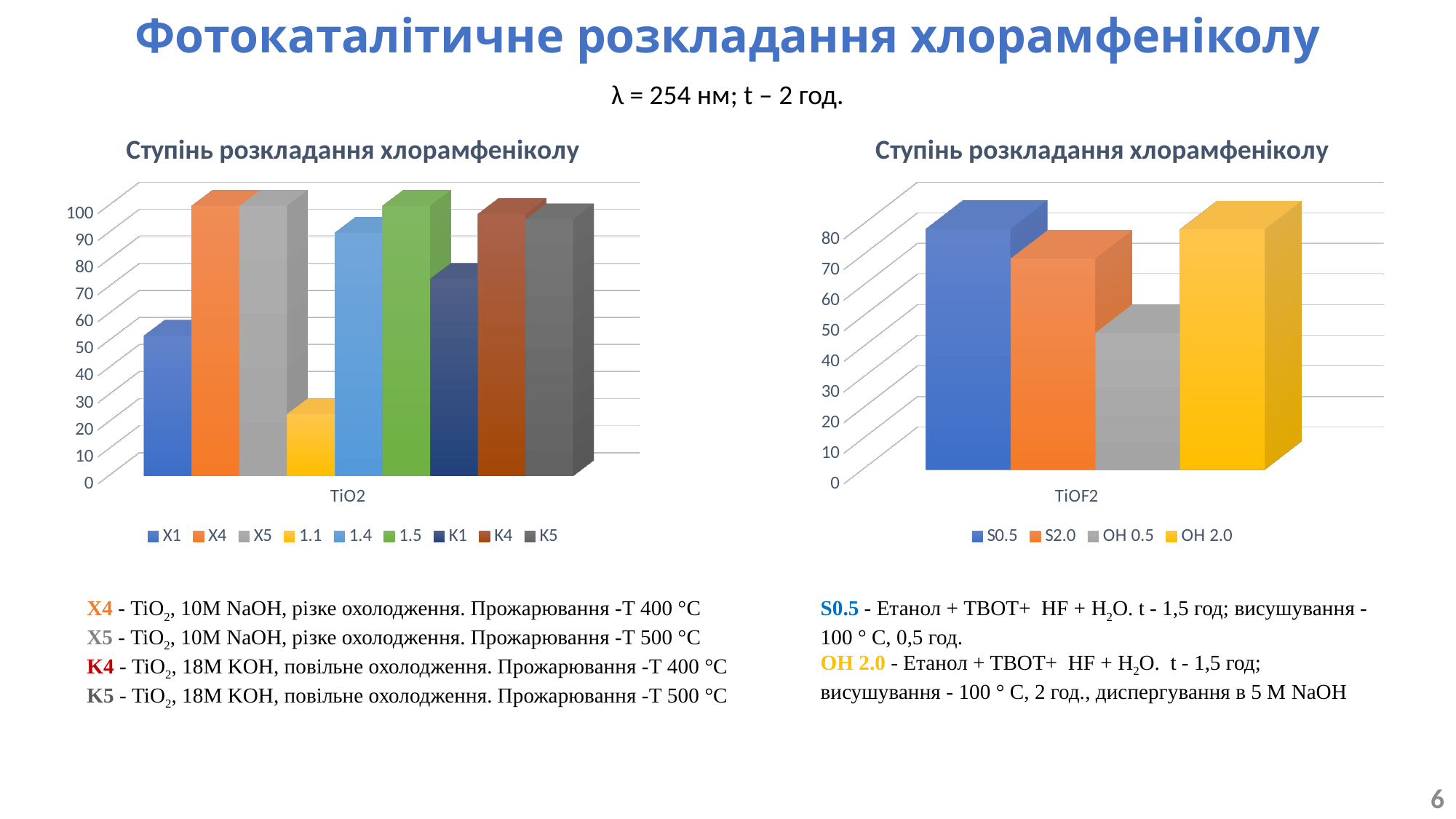
In the right chart, is the value for OH 0.5 greater or less than 60? less In the left chart, which is larger, the value for X1 or the value for 1.1? X1 In the left chart, is the value for 1.1 greater or less than 40? less In the right chart, which series has the lowest value? OH 0.5 How many series does the legend of the left chart list? 9 What kind of chart is the left chart on the slide? bar chart In the right chart, is the value for S2.0 greater or less than 60? greater What is the category label on the x axis of the right chart? TiOF2 In the right chart, which is larger, the value for S2.0 or the value for OH 0.5? S2.0 How many series does the legend of the right chart list? 4 In the left chart, which series has the lowest value? 1.1